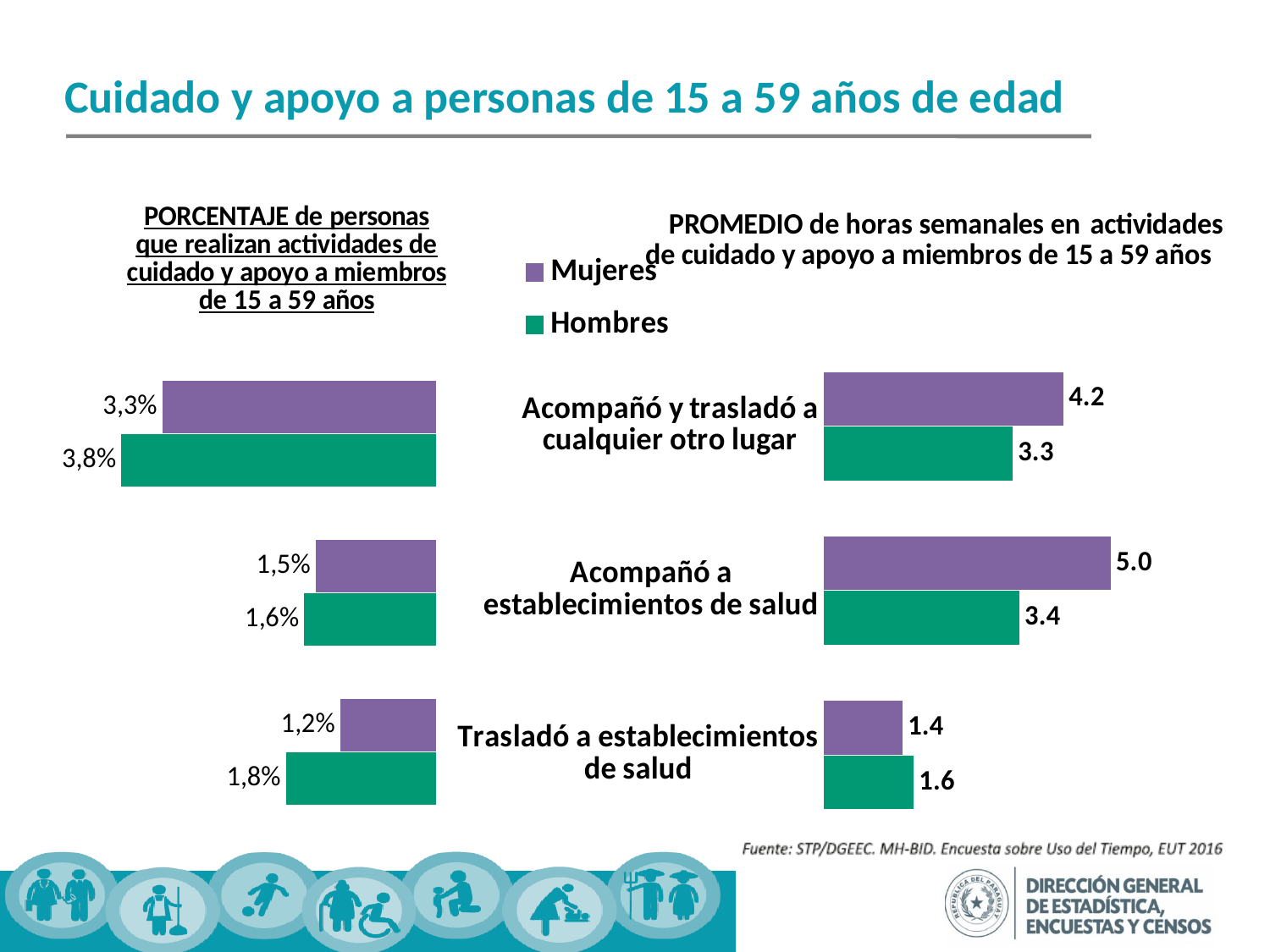
In the PORCENTAJE chart, which category has the lowest value for Mujeres? Trasladó a establecimientos de salud How many categories are shown in the PORCENTAJE chart? 3 How many series does the legend list? 2 In the PORCENTAJE chart, what is the difference between Hombres and Mujeres for 'Trasladó a establecimientos de salud'? 0,6% What kind of chart is the PROMEDIO de horas semanales chart? Bar chart In the PROMEDIO de horas semanales chart, which is larger for 'Trasladó a establecimientos de salud', Mujeres or Hombres? Hombres In the PORCENTAJE chart, what is the value for Hombres for 'Trasladó a establecimientos de salud'? 1,8% In the PROMEDIO de horas semanales chart, which category has the highest value for Mujeres? Acompañó a establecimientos de salud In the PORCENTAJE chart, what is the value for Mujeres for 'Acompañó y trasladó a cualquier otro lugar'? 3,3% In the PROMEDIO de horas semanales chart, what is the value for Mujeres for 'Acompañó a establecimientos de salud'? 5.0 In the PROMEDIO de horas semanales chart, what is the difference between Mujeres and Hombres for 'Acompañó a establecimientos de salud'? 1.6 In the PROMEDIO de horas semanales chart, what is the value for Hombres for 'Acompañó y trasladó a cualquier otro lugar'? 3.3